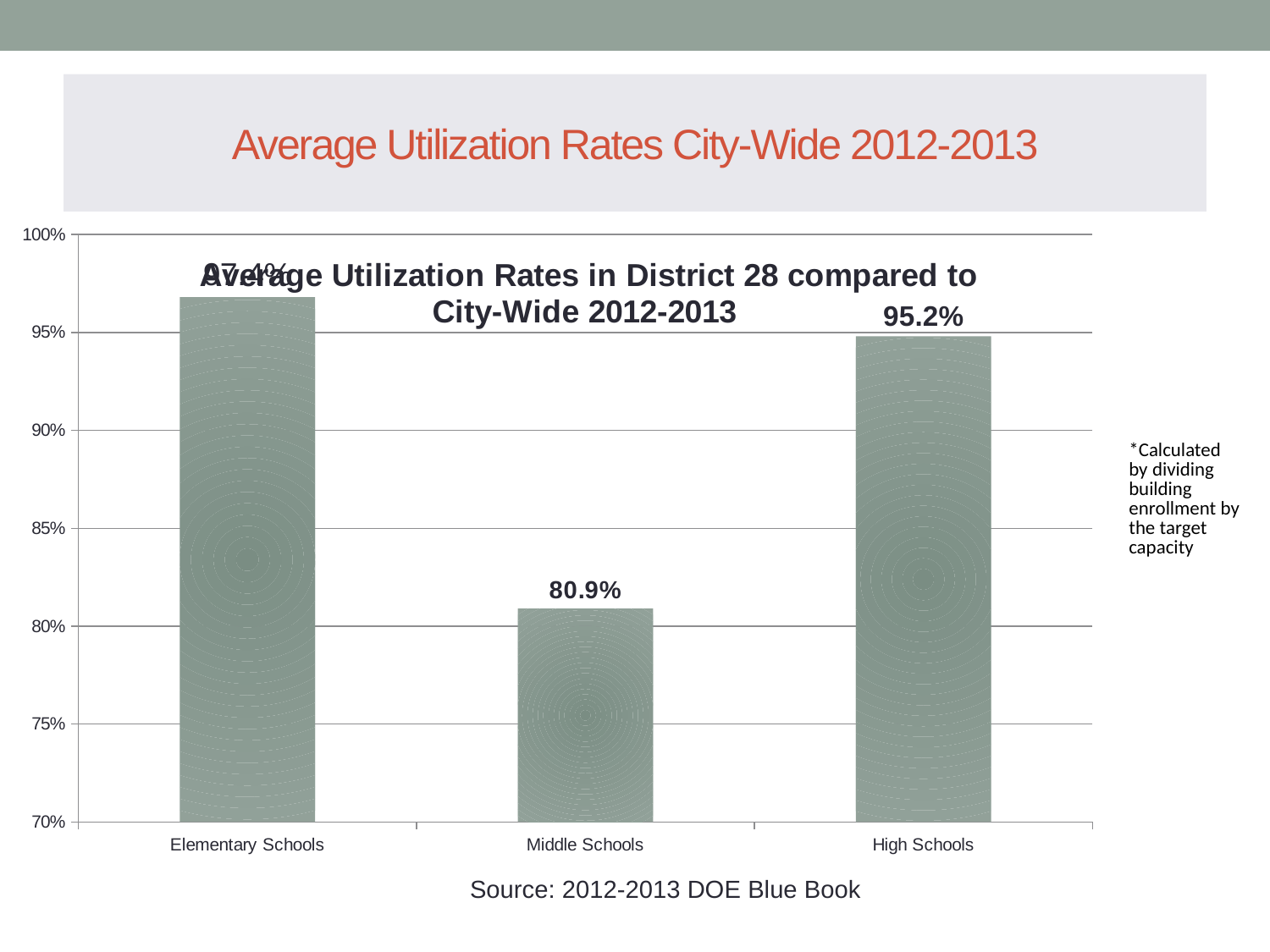
What source is cited below the chart? 2012-2013 DOE Blue Book What is the highest value shown on the vertical axis? 100% What is the average utilization rate for High Schools? 95.2% How many school types are shown on the chart? 3 How many percentage points higher is the High Schools rate than the Middle Schools rate? 14.3 percentage points Which school type has the lowest average utilization rate? Middle Schools Is the value for Middle Schools greater or less than 85%? less Which school type has the highest average utilization rate? Elementary Schools What is the average utilization rate for Middle Schools? 80.9% What kind of chart is shown on the slide? Bar chart Is the value for Elementary Schools greater or less than 95%? greater Which has a higher utilization rate, Middle Schools or High Schools? High Schools